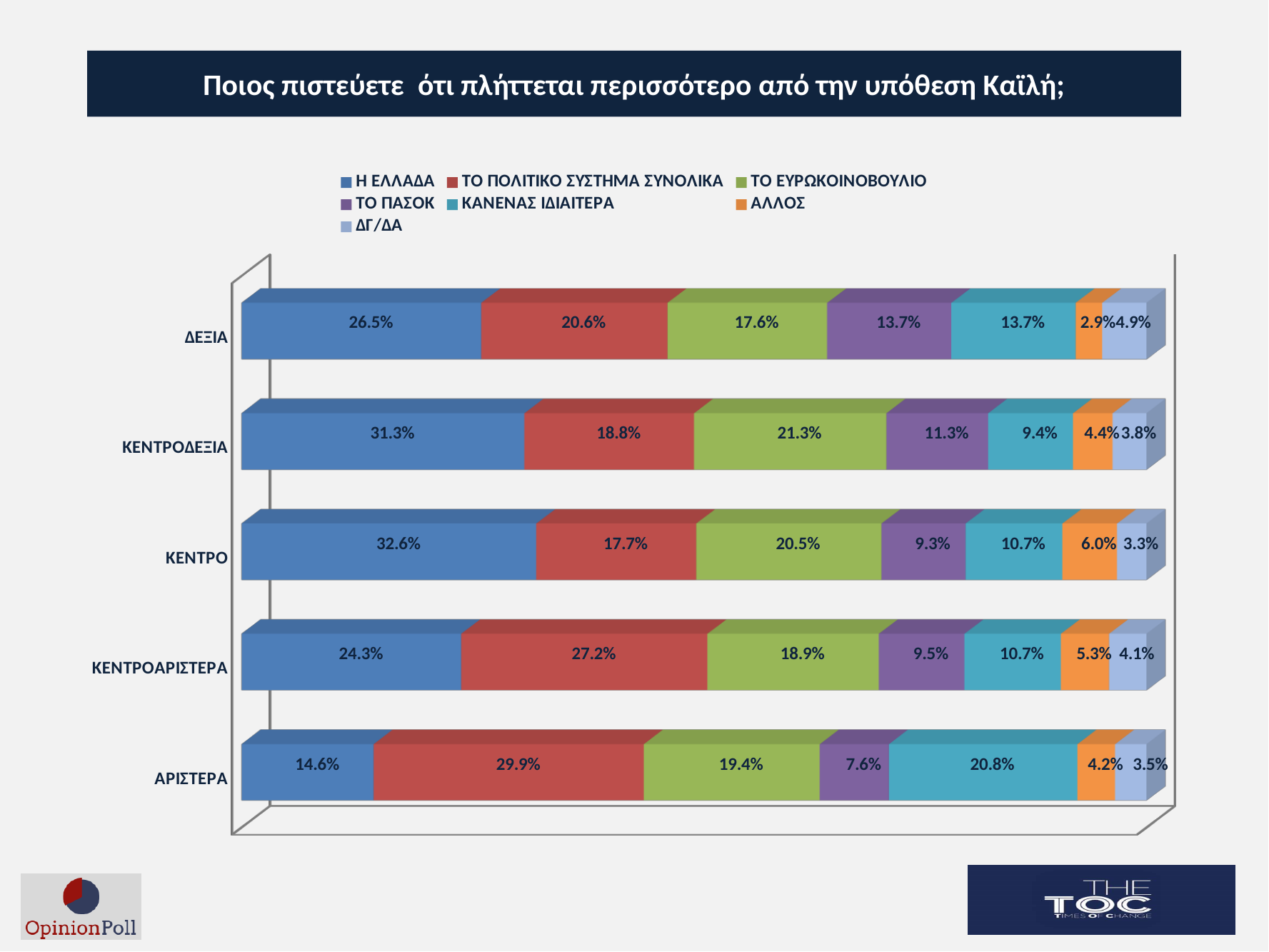
How much higher is the ΤΟ ΕΥΡΩΚΟΙΝΟΒΟΥΛΙΟ value for ΚΕΝΤΡΟΔΕΞΙΑ than for ΔΕΞΙΑ? 3.7 percentage points What percentage of ΚΕΝΤΡΟ respondents answered Η ΕΛΛΑΔΑ? 32.6% How many categories (bars) are shown on the chart? 5 What is the value for ΚΑΝΕΝΑΣ ΙΔΙΑΙΤΕΡΑ in the ΑΡΙΣΤΕΡΑ bar? 20.8% What kind of chart is shown on the slide? Stacked bar chart What is the value for ΤΟ ΠΑΣΟΚ in the ΔΕΞΙΑ bar? 13.7% How many series does the legend list? 7 Which has a larger ΑΛΛΟΣ value, ΚΕΝΤΡΟ or ΚΕΝΤΡΟΑΡΙΣΤΕΡΑ? ΚΕΝΤΡΟ Which category has the lowest value for ΤΟ ΠΑΣΟΚ? ΑΡΙΣΤΕΡΑ What is the title of the chart? Ποιος πιστεύετε ότι πλήττεται περισσότερο από την υπόθεση Καϊλή; Which category has the highest value for Η ΕΛΛΑΔΑ? ΚΕΝΤΡΟ Which category has the highest value for ΤΟ ΠΟΛΙΤΙΚΟ ΣΥΣΤΗΜΑ ΣΥΝΟΛΙΚΑ? ΑΡΙΣΤΕΡΑ